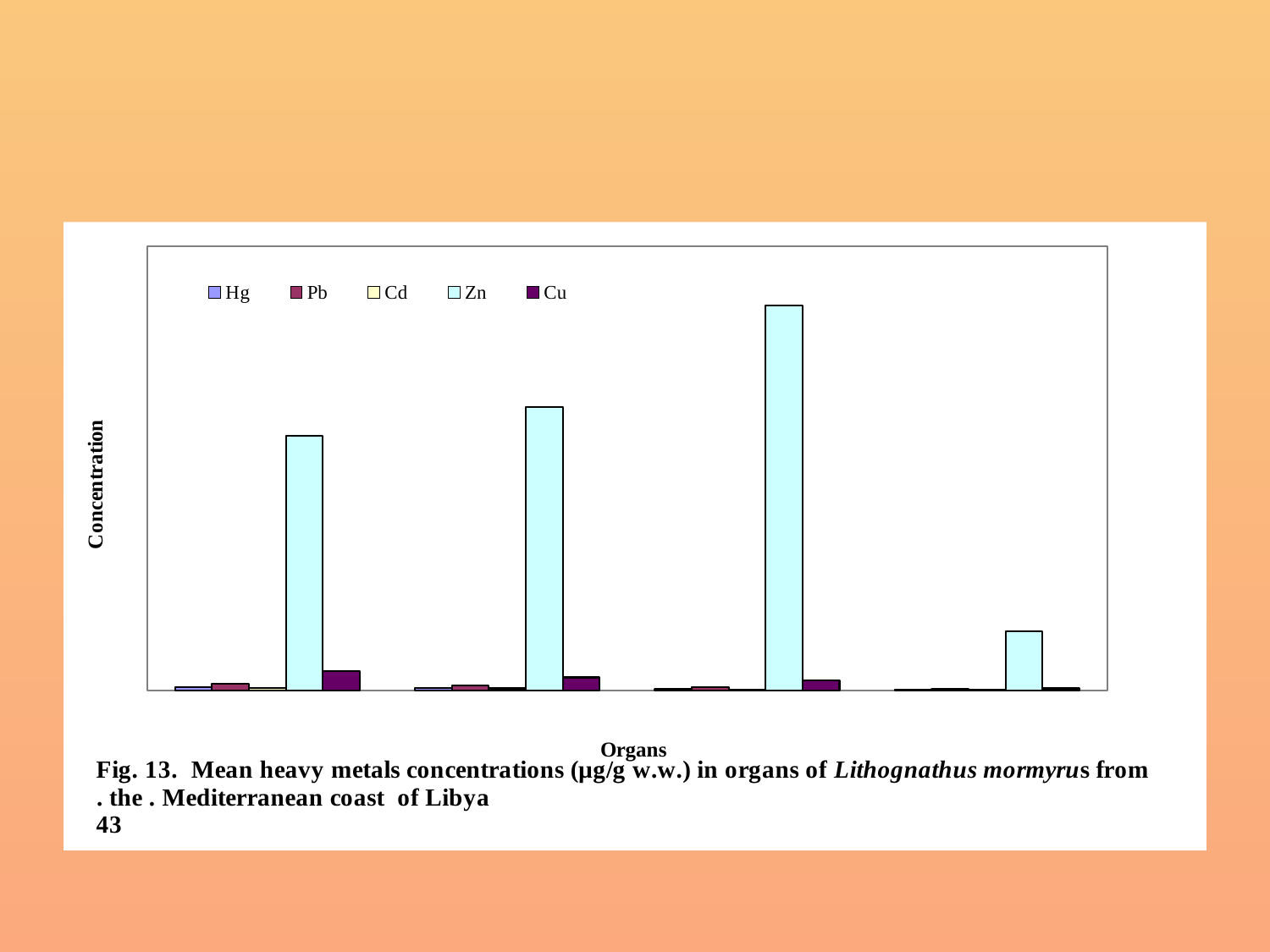
Which metals are listed in the chart's legend? Hg, Pb, Cd, Zn, Cu Do the Zn bars rise or fall from the first organ group to the third organ group? rise Which metal has the tallest bar in every organ group? Zn What kind of chart is shown on the slide? bar chart Which is taller, the Zn bar in the second group from the left or the Zn bar in the third group? the third group How many series does the legend list? 5 How many groups of bars (organs) are plotted along the x axis? 4 What is the title of the chart's x axis? Organs In which organ group, counting from the left, is the Zn bar the tallest? the third group In which organ group, counting from the left, is the Zn bar the shortest? the fourth group Does the Zn bar rise or fall from the third organ group to the fourth organ group? fall In the first organ group from the left, which is larger, the Zn bar or the Cu bar? Zn